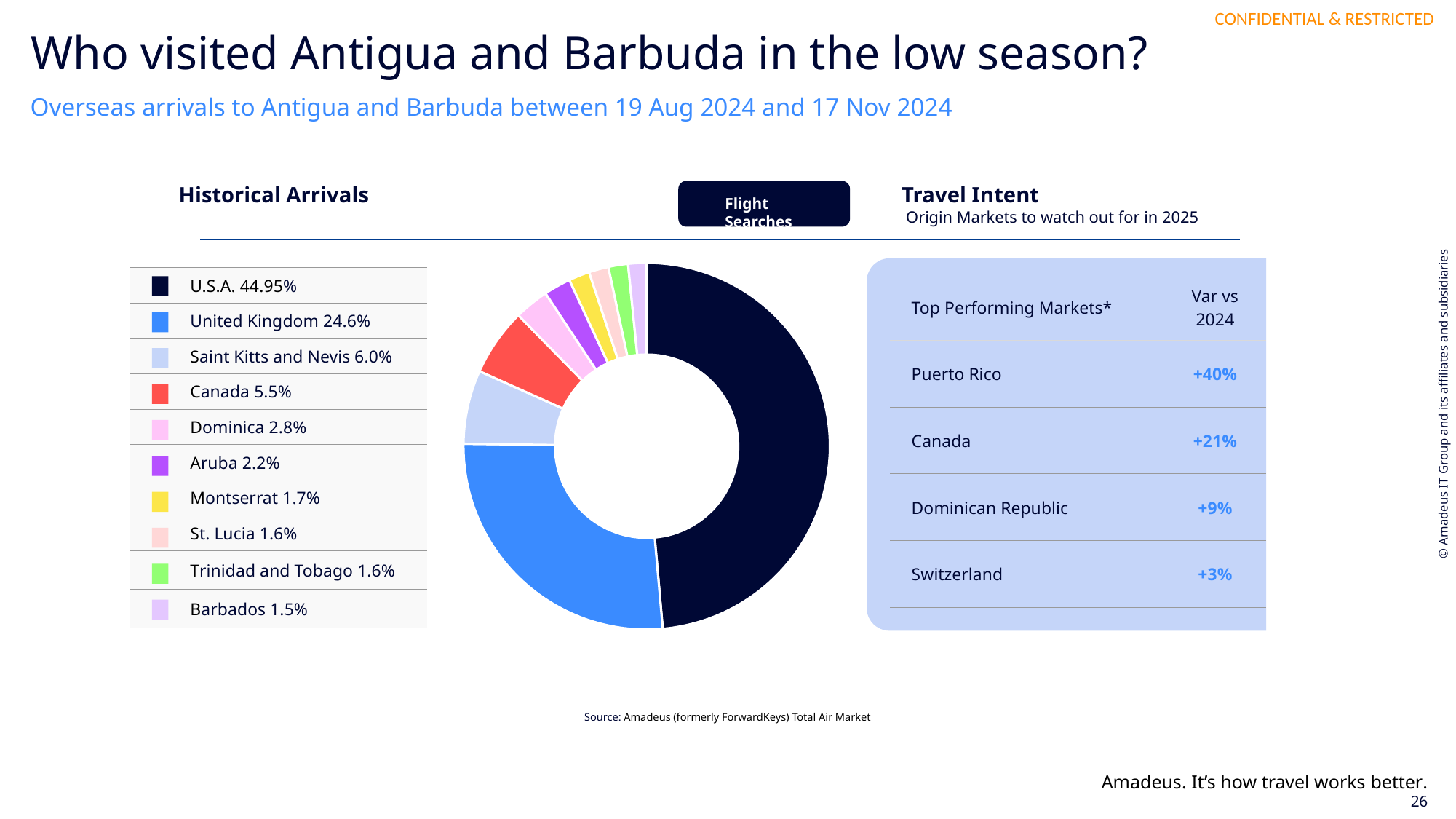
What type of chart is used to show Historical Arrivals? Doughnut chart Which origin market has the smallest slice in the Historical Arrivals pie chart? Barbados How many origin markets are listed in the legend of the Historical Arrivals chart? 10 What colour is the U.S.A. slice in the Historical Arrivals pie chart? Dark navy Which origin market has the largest slice in the Historical Arrivals pie chart? U.S.A. Which has a larger share of arrivals, the United Kingdom or Canada? United Kingdom What share of overseas arrivals does the U.S.A. account for in the Historical Arrivals pie chart? 44.95% What is the value shown for the United Kingdom in the Historical Arrivals pie chart? 24.6% What is the difference in percentage points between the U.S.A. and the United Kingdom shares? 20.35% What percentage is shown for Canada in the Historical Arrivals pie chart? 5.5% What value does the legend give for Saint Kitts and Nevis? 6.0% How much larger is the Saint Kitts and Nevis share than the Canada share? 0.5%